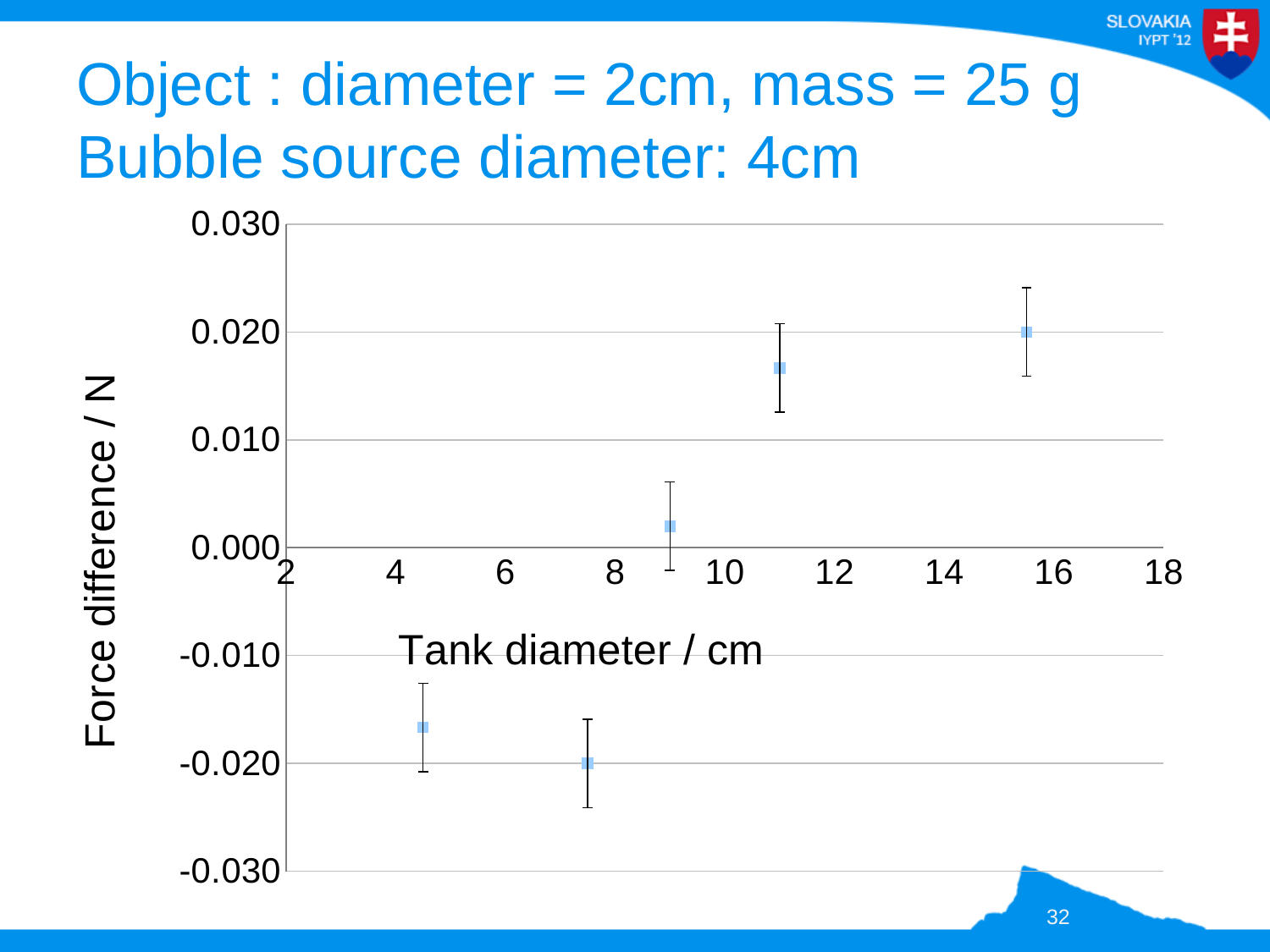
What is the label of the x axis? Tank diameter / cm Overall, does the force difference rise or fall as the tank diameter increases? rise Is the force difference for the point near 7.5 cm tank diameter greater or less than -0.010 N? less Is the force difference for the point near 11 cm tank diameter greater or less than 0.010 N? greater What kind of chart is shown on the slide? scatter chart Is the force difference for the point at the largest tank diameter greater or less than 0.010 N? greater What is the label of the y axis? Force difference / N How many data points are plotted on the chart? 5 Does the point with the highest force difference occur at the largest tank diameter plotted? yes Which point has the larger force difference, the one near 4.5 cm or the one near 7.5 cm tank diameter? the one near 4.5 cm